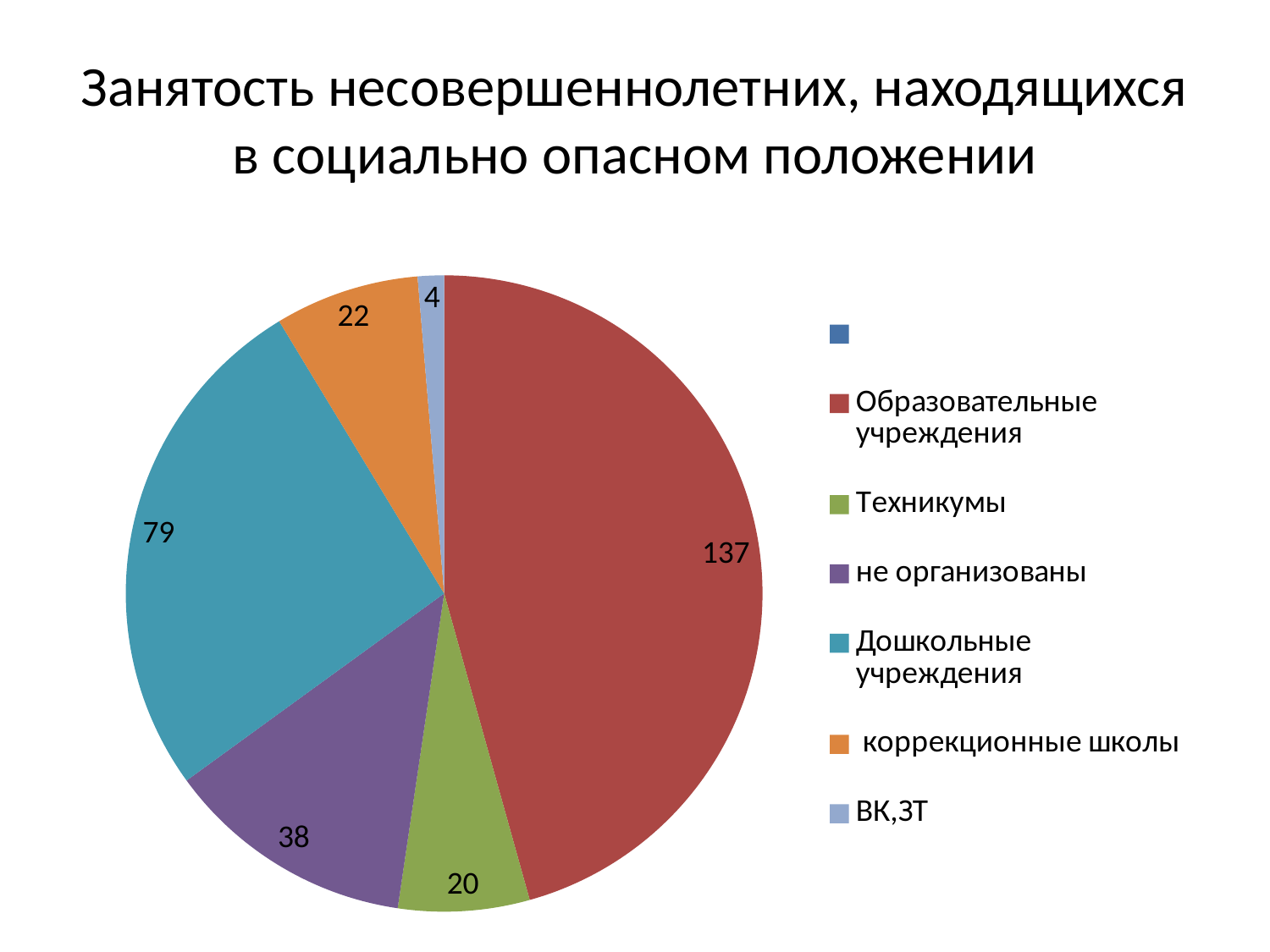
What type of chart is shown on the slide? pie chart Which is larger, the value for не организованы or the value for коррекционные школы? не организованы What is the value for ВК,ЗТ? 4 What is the difference between the values for Образовательные учреждения and Дошкольные учреждения? 58 What is the value for Образовательные учреждения? 137 What is the title of the chart? Занятость несовершеннолетних, находящихся в социально опасном положении Which category has the largest slice of the pie? Образовательные учреждения What is the value for не организованы? 38 What is the value for Техникумы? 20 What is the value for Дошкольные учреждения? 79 Which category has the smallest slice of the pie? ВК,ЗТ What is the value for коррекционные школы? 22